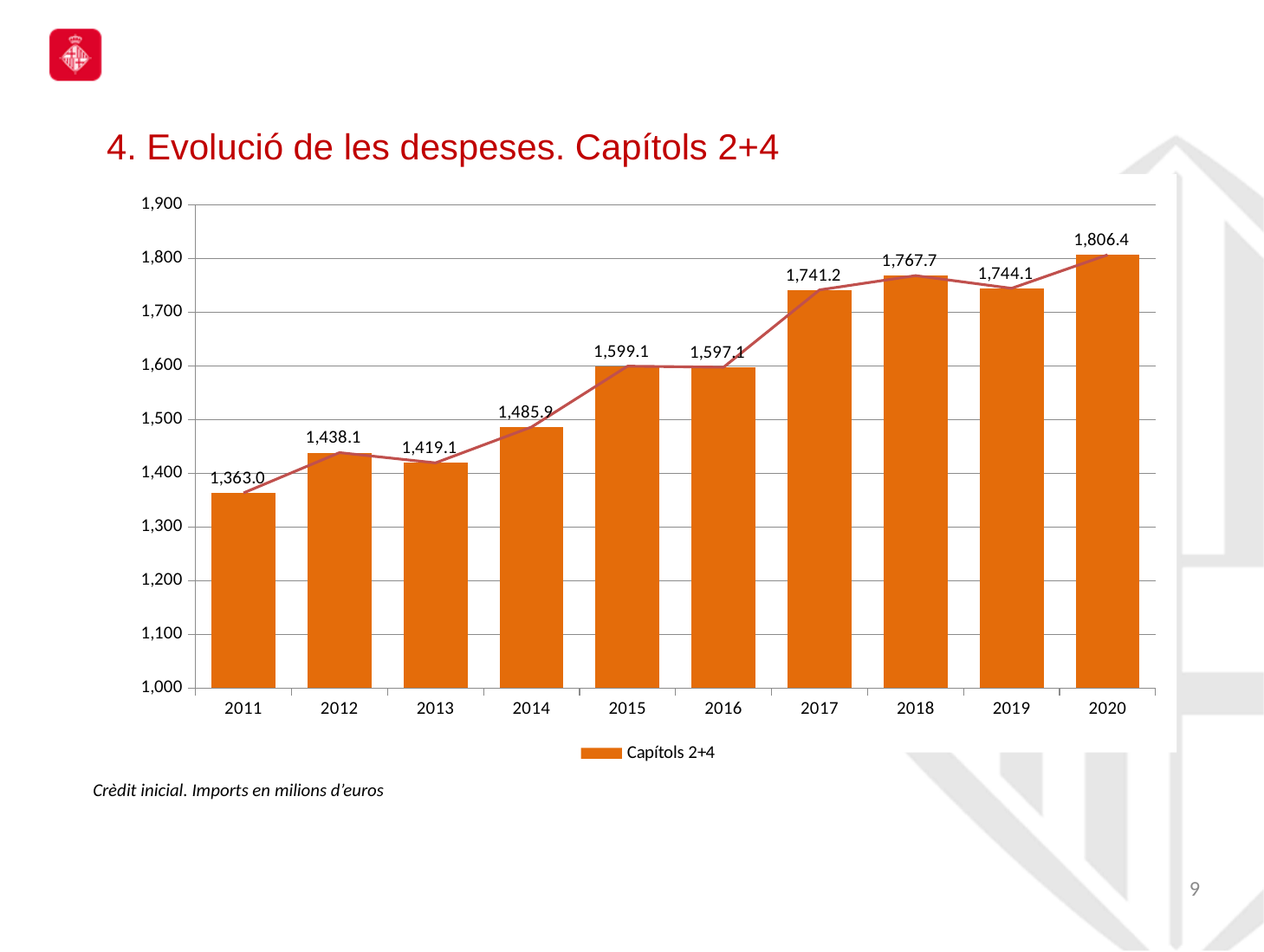
How many years are shown on the x axis? 10 What is the value for 2016? 1,597.1 What is the legend entry for the bars? Capítols 2+4 What is the value for 2019? 1,744.1 What is the value for 2011? 1,363.0 Which year has the lowest value? 2011 Which year has the highest value? 2020 What kind of chart is this? combination bar and line chart What is the difference between the values for 2020 and 2011? 443.4 What is the difference between the values for 2018 and 2017? 26.5 Is the value for 2014 greater or less than 1,500? less Which is larger, the value for 2012 or the value for 2013? 2012